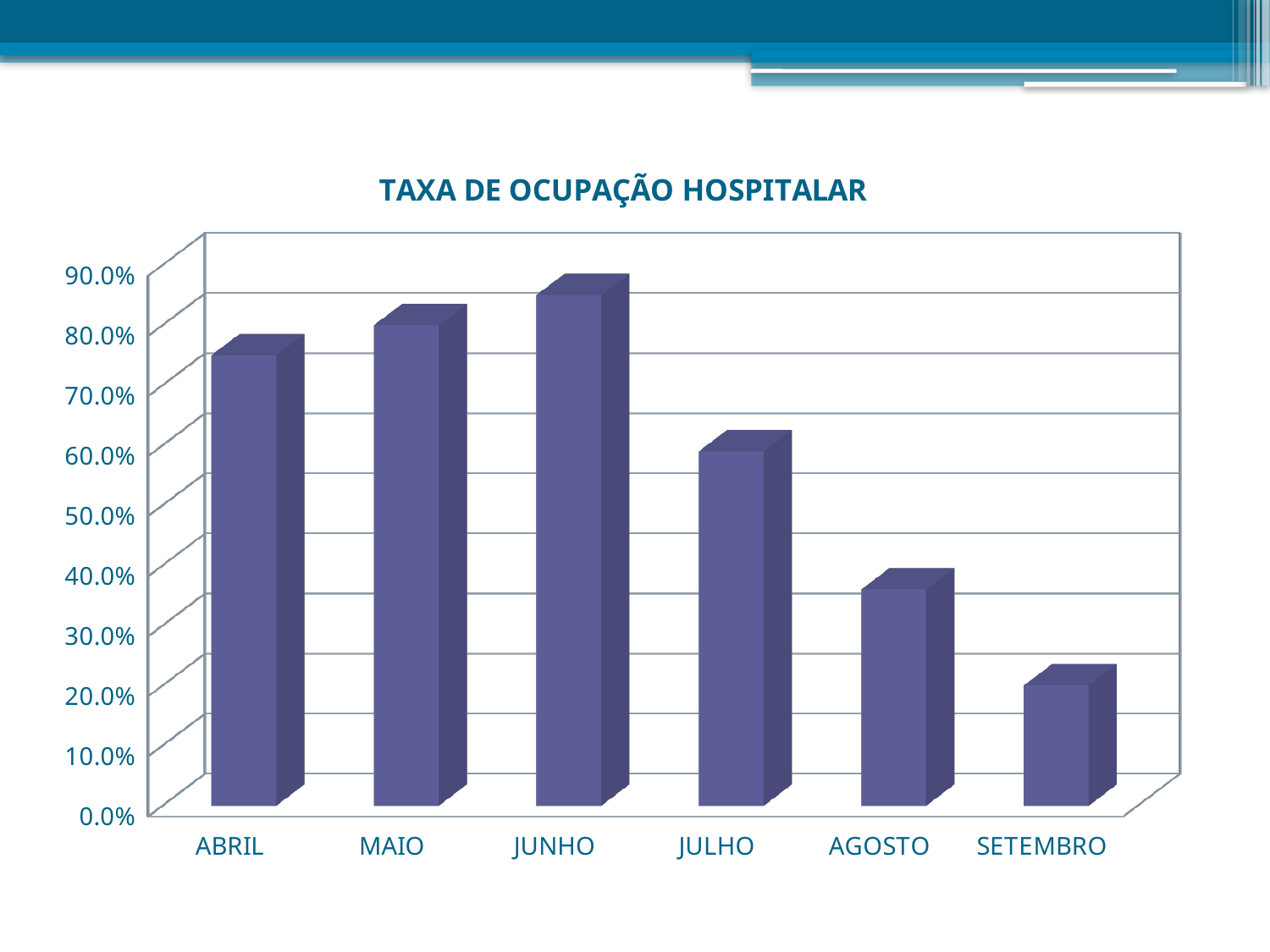
Is the value for JUNHO greater or less than 80.0%? greater Which month has the lowest occupancy rate? SETEMBRO What kind of chart is shown on the slide? bar chart How many months are shown on the x axis of the chart? 6 Is the value for JULHO greater or less than 70.0%? less What is the title of the chart? TAXA DE OCUPAÇÃO HOSPITALAR Do the values rise or fall from JUNHO to SETEMBRO? fall Which is larger, the value for JUNHO or the value for JULHO? JUNHO Is the value for ABRIL greater or less than 70.0%? greater Which month has the highest occupancy rate? JUNHO